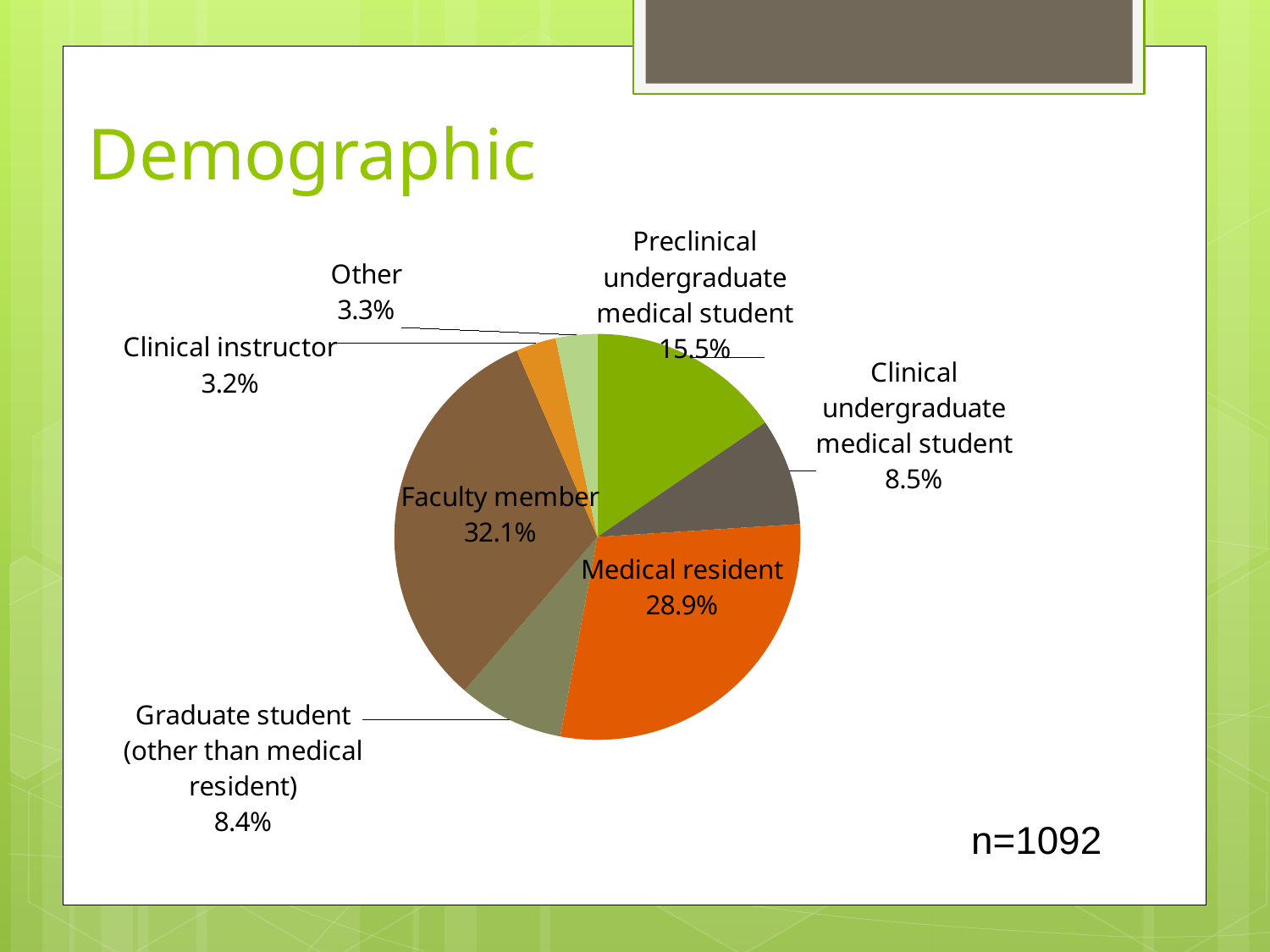
What is the difference in percentage points between Faculty member and Medical resident? 3.2% What percentage is shown for Clinical undergraduate medical student? 8.5% What percentage is shown for Clinical instructor? 3.2% How many categories are shown in the pie chart? 7 What percentage is shown for Medical resident? 28.9% What is the title of the slide containing the pie chart? Demographic Which is larger, the slice for Medical resident or the slice for Preclinical undergraduate medical student? Medical resident What share of the pie does Faculty member represent? 32.1% What percentage is shown for Graduate student (other than medical resident)? 8.4% What percentage is shown for Preclinical undergraduate medical student? 15.5% What kind of chart is shown on the slide? pie chart Which category has the largest slice of the pie? Faculty member